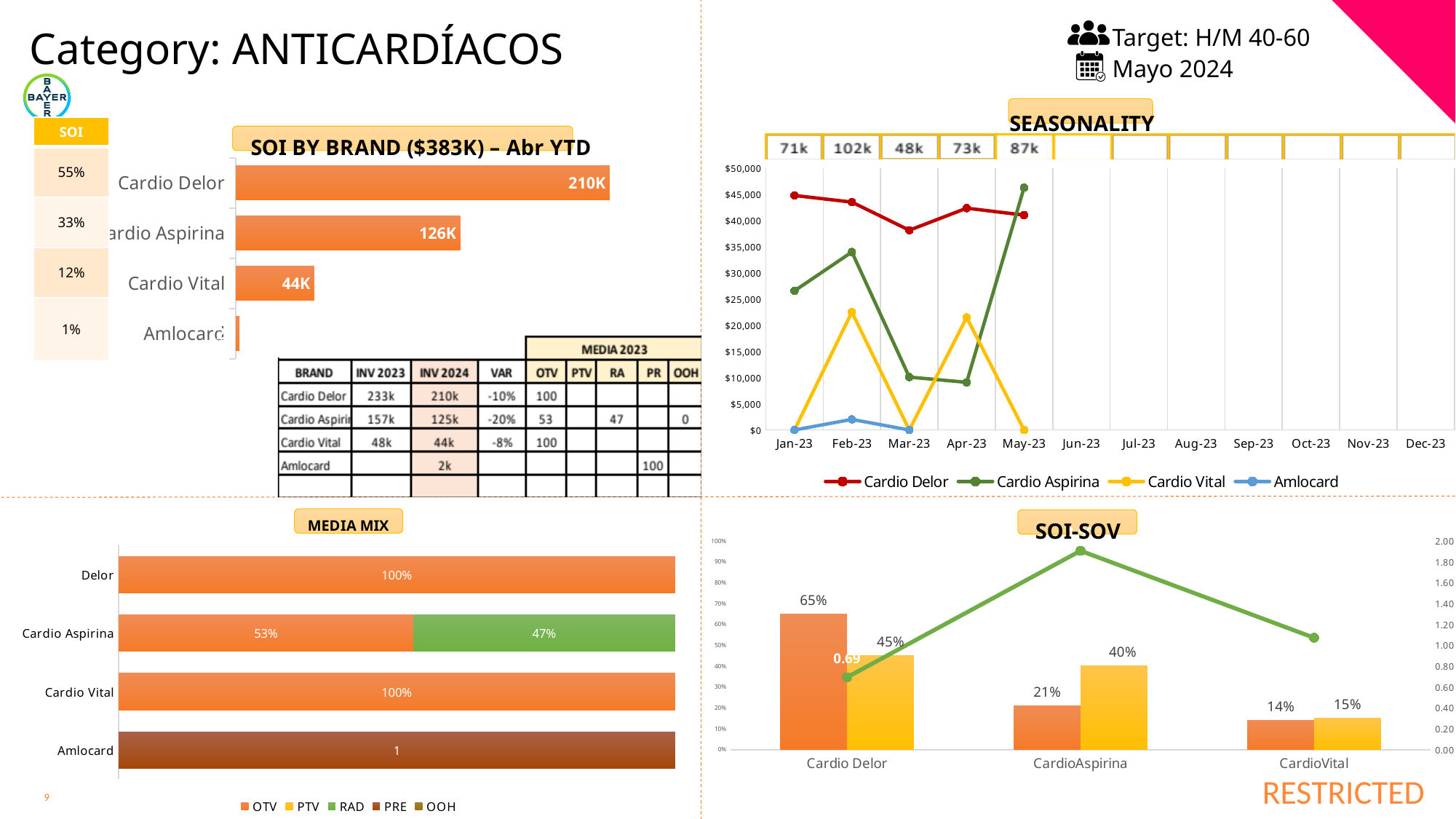
How many series does the legend of the MEDIA MIX chart list? 5 In the SOI BY BRAND chart, what is the value for Cardio Delor? 210K In the MEDIA MIX chart, what is the RAD share for Cardio Aspirina? 47% In the SOI BY BRAND chart, what is the difference between Cardio Delor and Cardio Vital? 166K In the SEASONALITY chart, which series has the highest value in May-23? Cardio Aspirina In the SOI BY BRAND chart, which brand has the lowest value? Amlocard How many series does the legend of the SEASONALITY chart list? 4 In the SOI-SOV chart, what is the value of the first (orange) bar for CardioAspirina? 21% In the SOI BY BRAND chart, what is the value for Cardio Aspirina? 126K In the SEASONALITY chart, is the value for Cardio Delor in Jan-23 greater or less than $40,000? greater What kind of chart is the SEASONALITY chart? Line chart In the SOI-SOV chart, which is larger for CardioVital: the orange bar or the yellow bar? The yellow bar (15%)